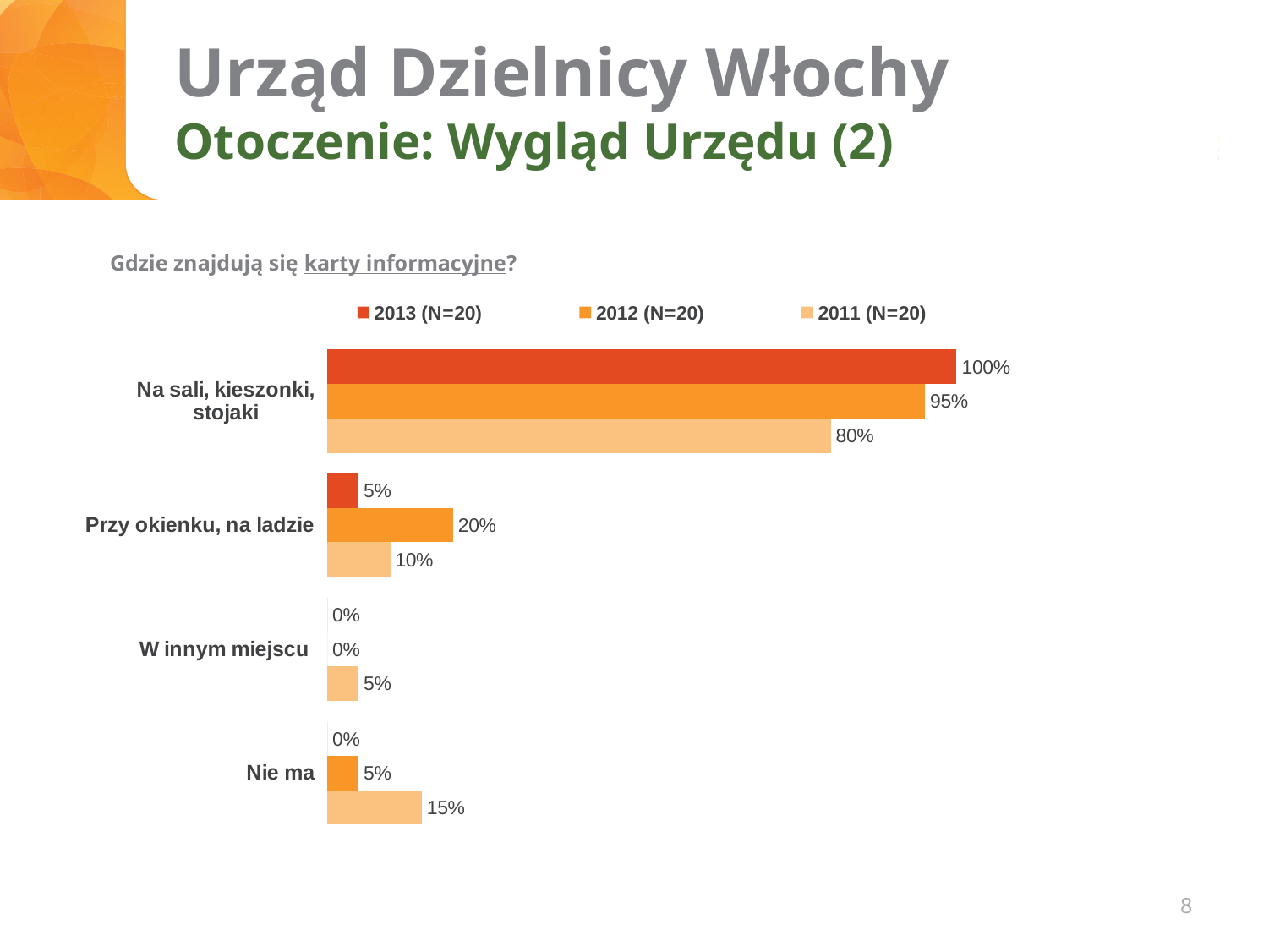
Which category has the highest value in the 2011 (N=20) series? Na sali, kieszonki, stojaki What kind of chart is shown on the slide? Bar chart What is the value for 'Nie ma' in the 2011 (N=20) series? 15% What is the value for 'Przy okienku, na ladzie' in the 2012 (N=20) series? 20% What is the difference between the 2013 (N=20) and 2011 (N=20) values for 'Na sali, kieszonki, stojaki'? 20% How many categories are shown on the chart? 4 How many series does the legend list? 3 Which category has the lowest value in the 2012 (N=20) series? W innym miejscu Which is larger for 'Przy okienku, na ladzie': the 2012 (N=20) value or the 2011 (N=20) value? 2012 (N=20) What is the value for 'Na sali, kieszonki, stojaki' in the 2013 (N=20) series? 100% What question does the chart answer, according to the text above it? Gdzie znajdują się karty informacyjne? What is the value for 'W innym miejscu' in the 2013 (N=20) series? 0%